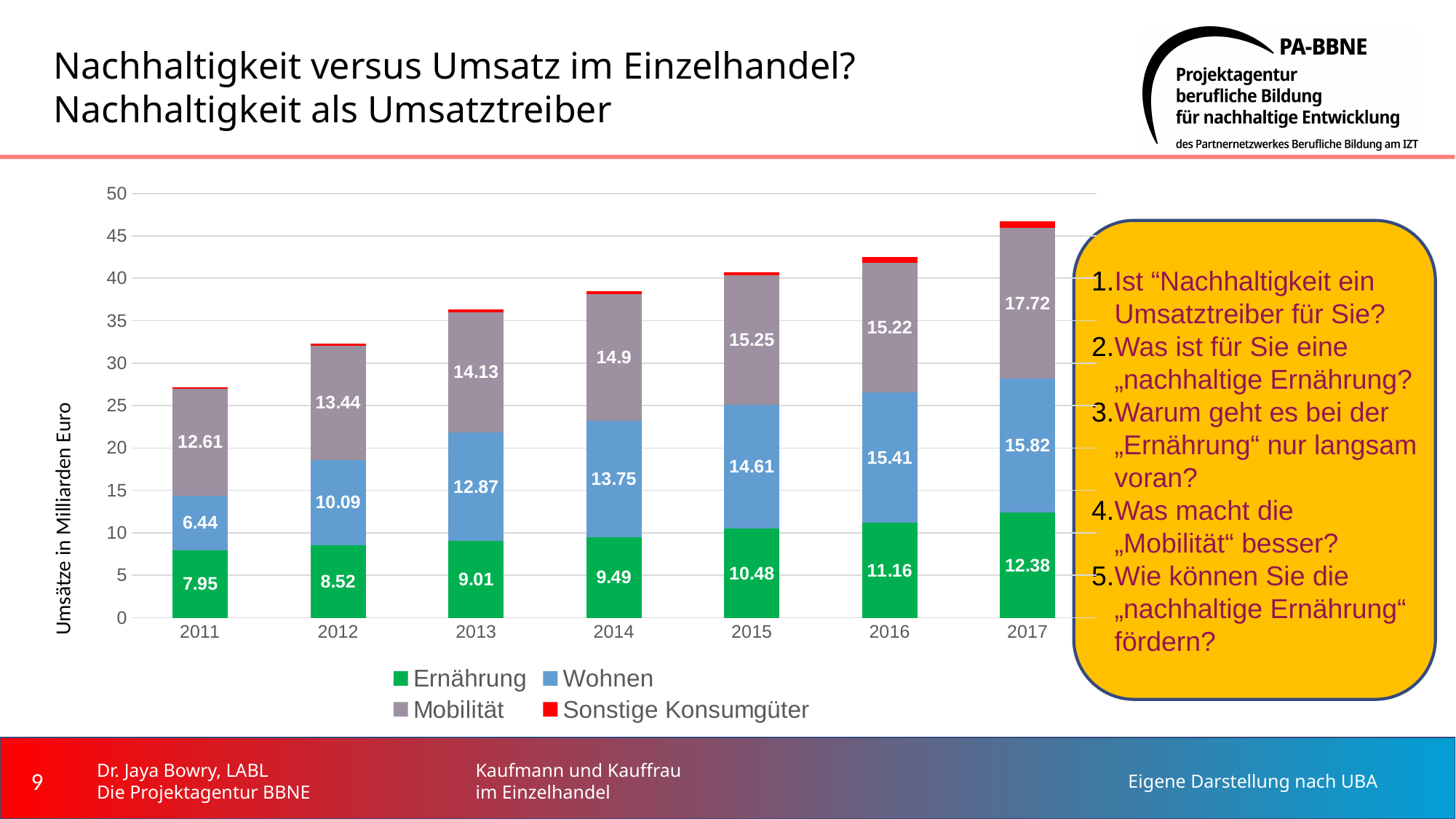
How many years are shown on the x axis? 7 What is the value for Ernährung in 2017? 12.38 What is the difference between the Wohnen values in 2017 and 2011? 9.38 In which year is the Mobilität value highest? 2017 What is the value for Mobilität in 2015? 15.25 Does the Ernährung value rise or fall from 2011 to 2017? rise Which is larger in 2012: the Wohnen value or the Mobilität value? Mobilität How many series does the legend list? 4 What kind of chart is shown on the slide? stacked bar chart Is the total height of the 2017 stacked bar greater or less than 45? greater In which year is the Ernährung value lowest? 2011 What is the value for Wohnen in 2013? 12.87